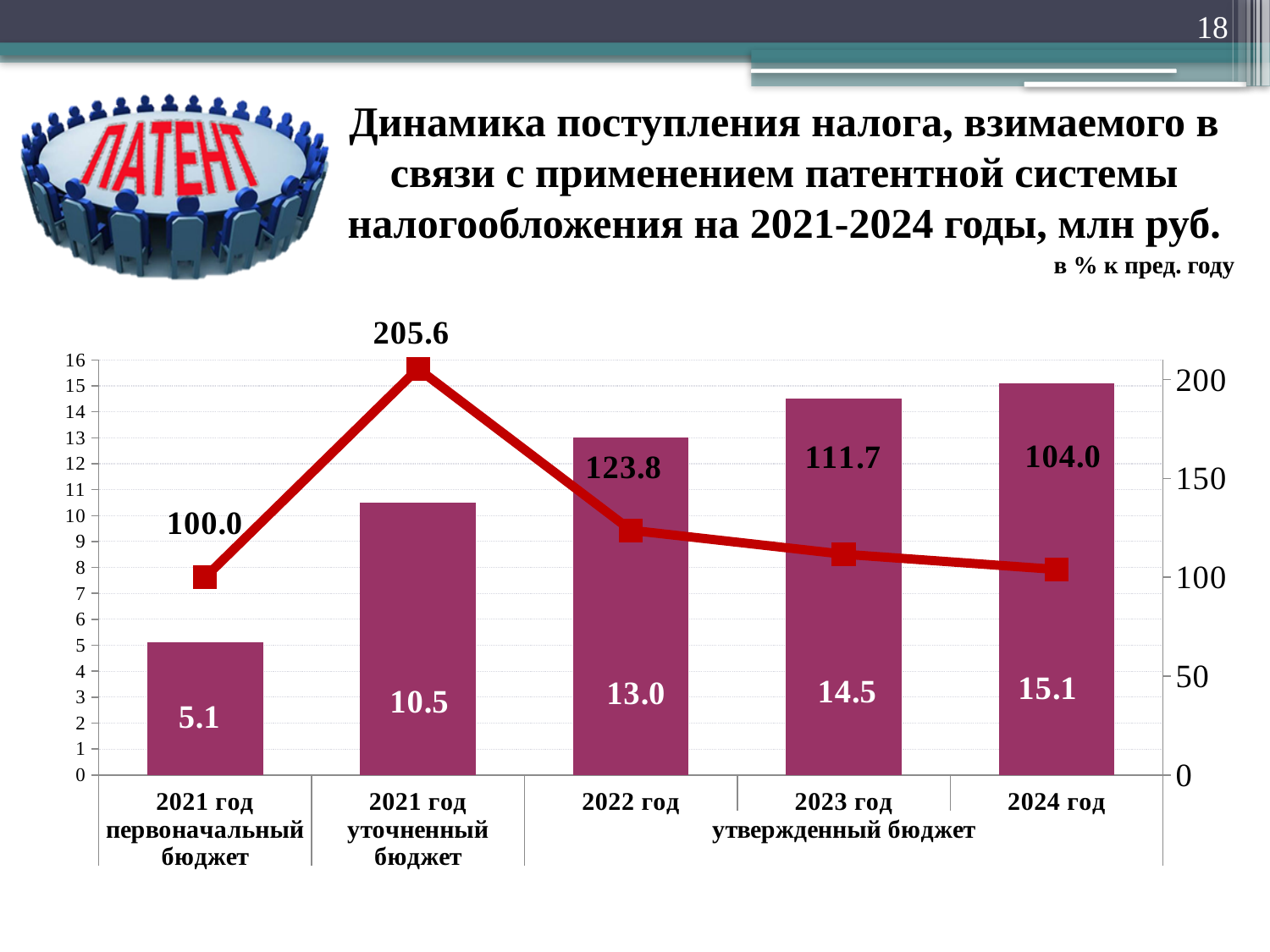
Which is larger: the line value for 2022 год or for 2023 год? 2022 год What is the line value (в % к пред. году) for 2021 год уточненный бюджет? 205.6 What is the bar value (млн руб.) for 2022 год? 13.0 What is the difference between the bar values for 2021 год уточненный бюджет and 2021 год первоначальный бюджет? 5.4 What is the bar value (млн руб.) for 2021 год первоначальный бюджет? 5.1 Which category has the lowest line value (в % к пред. году)? 2021 год первоначальный бюджет What is the difference between the bar values for 2024 год and 2023 год? 0.6 Do the bar values rise or fall from left to right along the x axis? rise How many categories are shown on the x axis? 5 What is the line value (в % к пред. году) for 2024 год? 104.0 Which category has the highest bar value? 2024 год What kind of chart is shown on the slide? combined bar and line chart